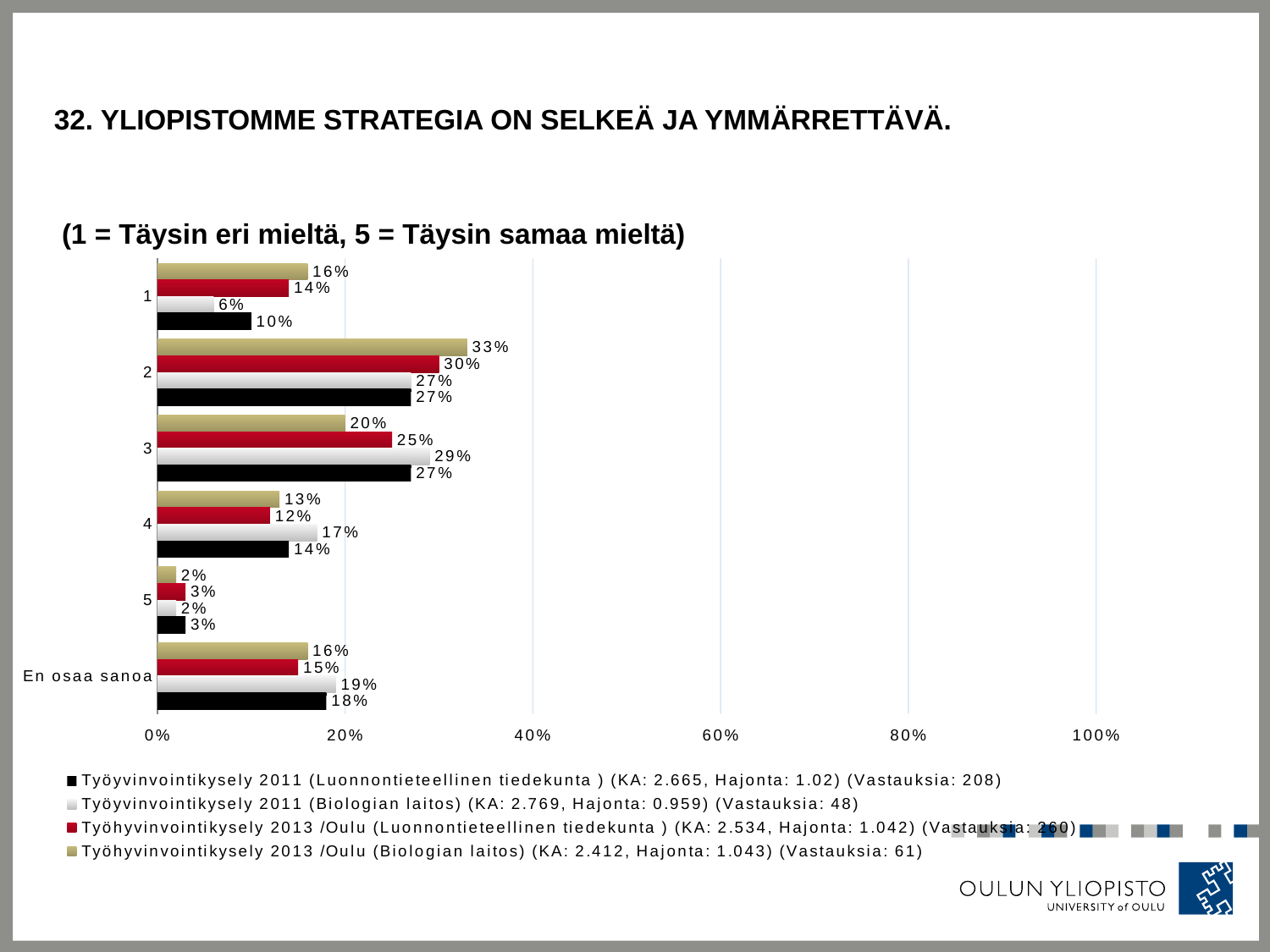
Which category has the lowest value in the Työyvinvointikysely 2011 (Biologian laitos) series? 5 What is the value for category 1 in the Työhyvinvointikysely 2013 /Oulu (Luonnontieteellinen tiedekunta) series? 14% What is the value for category 3 in the Työyvinvointikysely 2011 (Biologian laitos) series? 29% How many series does the legend list? 4 For category 3, which series has the larger value: Työhyvinvointikysely 2013 /Oulu (Biologian laitos) or Työyvinvointikysely 2011 (Biologian laitos)? Työyvinvointikysely 2011 (Biologian laitos) What kind of chart is shown on the slide? bar chart What is the difference between the Työhyvinvointikysely 2013 /Oulu (Biologian laitos) value and the Työyvinvointikysely 2011 (Biologian laitos) value for category 1? 10% Which category has the highest value in the Työhyvinvointikysely 2013 /Oulu (Biologian laitos) series? 2 What is the value for 'En osaa sanoa' in the Työyvinvointikysely 2011 (Luonnontieteellinen tiedekunta) series? 18% How many categories are shown on the vertical axis of the chart? 6 What is the value for category 2 in the Työhyvinvointikysely 2013 /Oulu (Biologian laitos) series? 33% Is the value for category 2 in the Työhyvinvointikysely 2013 /Oulu (Biologian laitos) series greater or less than 20%? greater